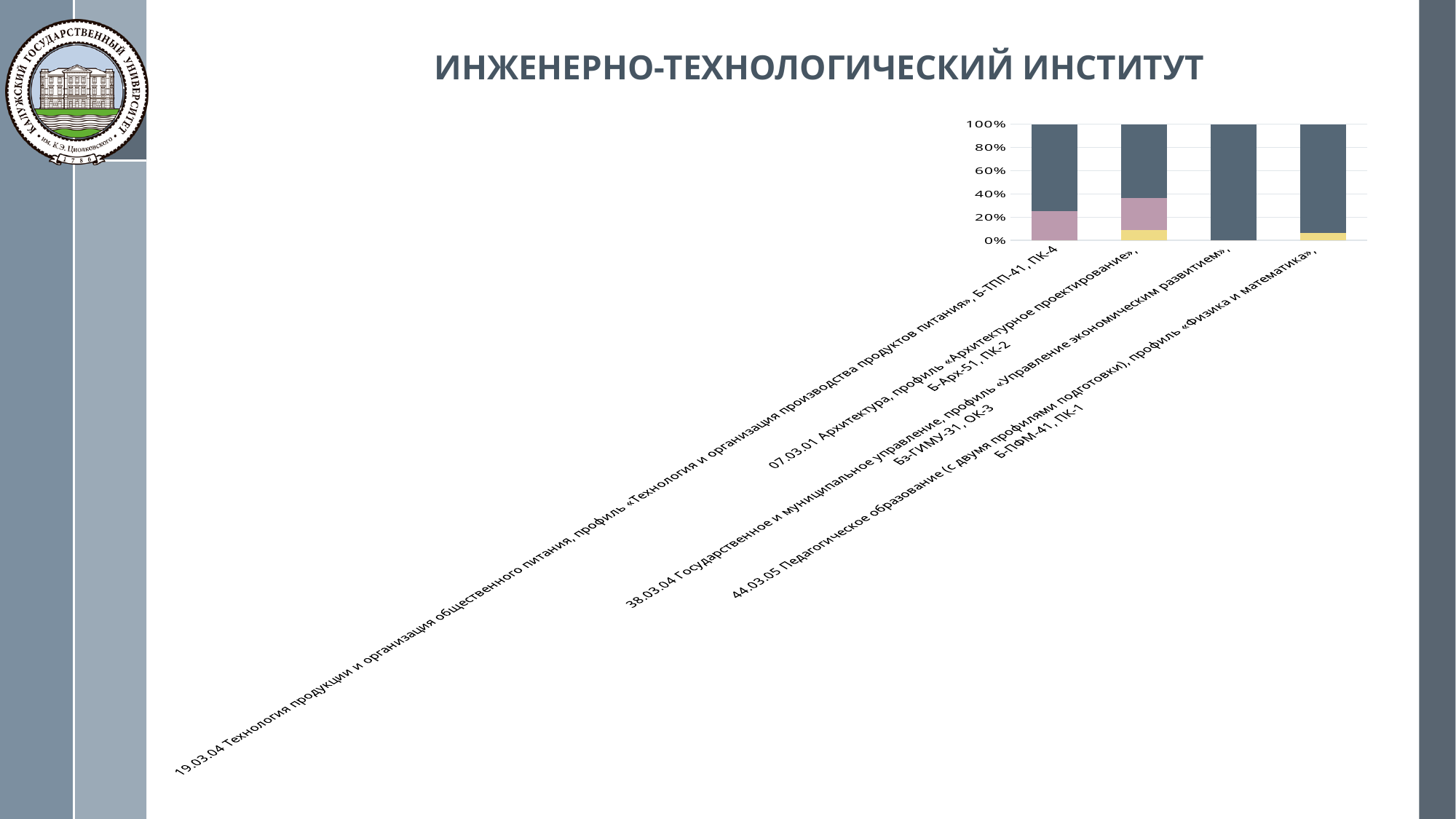
What is the total height of the bar for Б-ТПП-41, ПК-4 on the percentage axis? 100% How many categories (bars) does the chart show? 4 Is the yellow segment of the bar for Б-ПФМ-41, ПК-1 greater or less than 20%? less Is the pink segment of the bar for Б-ТПП-41, ПК-4 greater or less than 40%? less What kind of chart is shown on the slide? stacked bar chart Which bar has the largest dark grey segment? 38.03.04 Государственное и муниципальное управление, Бз-ГИМУ-31, ОК-3 Is the dark grey segment larger for Б-ПФМ-41, ПК-1 or for Б-Арх-51, ПК-2? Б-ПФМ-41, ПК-1 Which bar consists entirely of the dark grey segment, with no pink or yellow portion? 38.03.04 Государственное и муниципальное управление, Бз-ГИМУ-31, ОК-3 Is the dark grey segment of the bar for Б-ТПП-41, ПК-4 greater or less than 60%? greater What is the highest value shown on the vertical axis of the chart? 100% Which bar has the largest pink segment? 07.03.01 Архитектура, Б-Арх-51, ПК-2